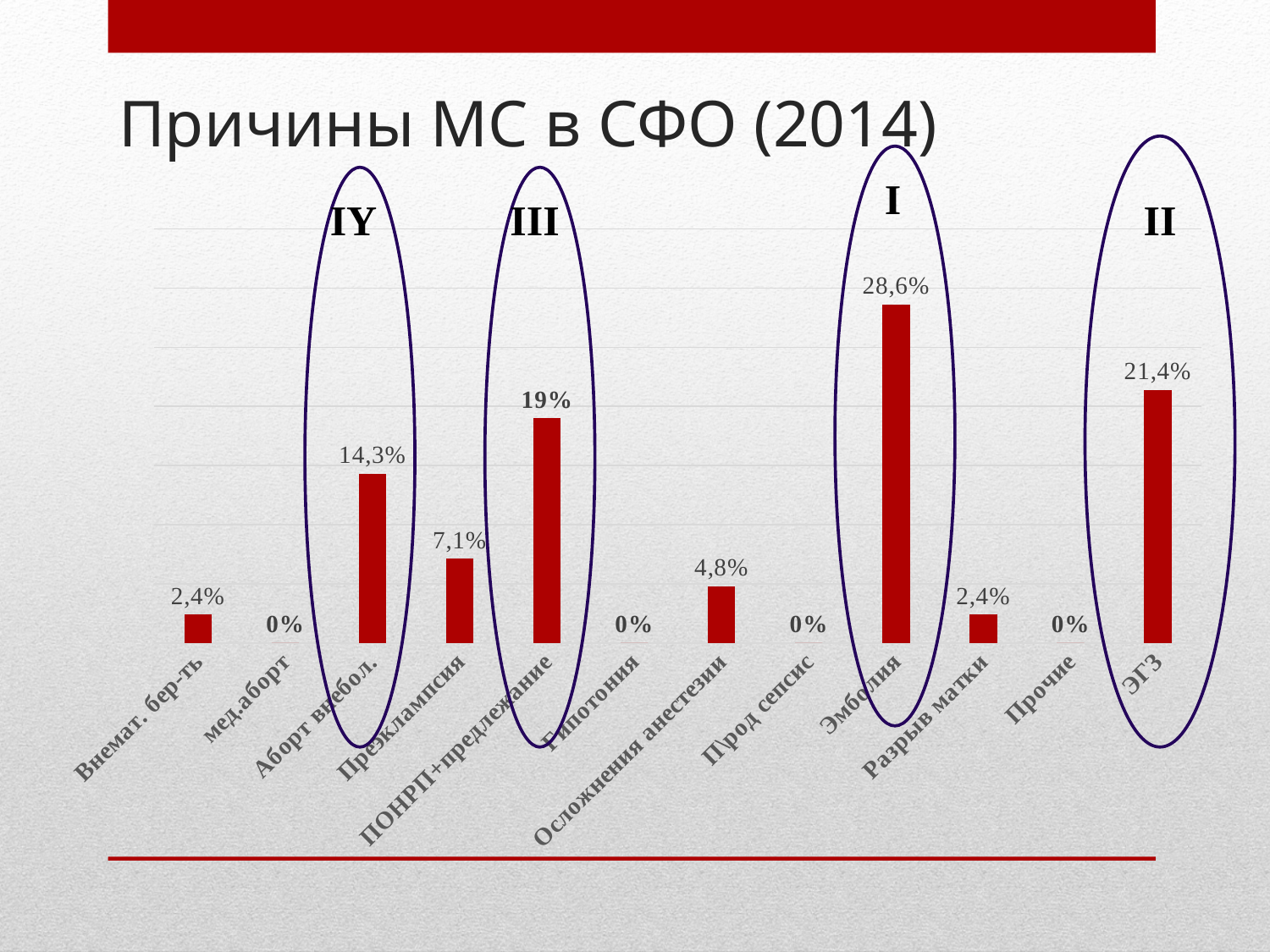
How many categories are shown on the x axis? 12 What is the title of the chart? Причины МС в СФО (2014) What is the difference between the values for Эмболия and ЭГЗ? 7,2% Which category has the highest value? Эмболия What is the value for Аборт внебол.? 14,3% What is the value for ЭГЗ? 21,4% What kind of chart is shown on the slide? Bar chart What is the difference between the values for ПОНРП+предлежание and Преэклампсия? 11,9% Which is larger, the value for Аборт внебол. or the value for Преэклампсия? Аборт внебол. What is the value for ПОНРП+предлежание? 19% What is the value for Эмболия? 28,6% What is the value for Осложнения анестезии? 4,8%